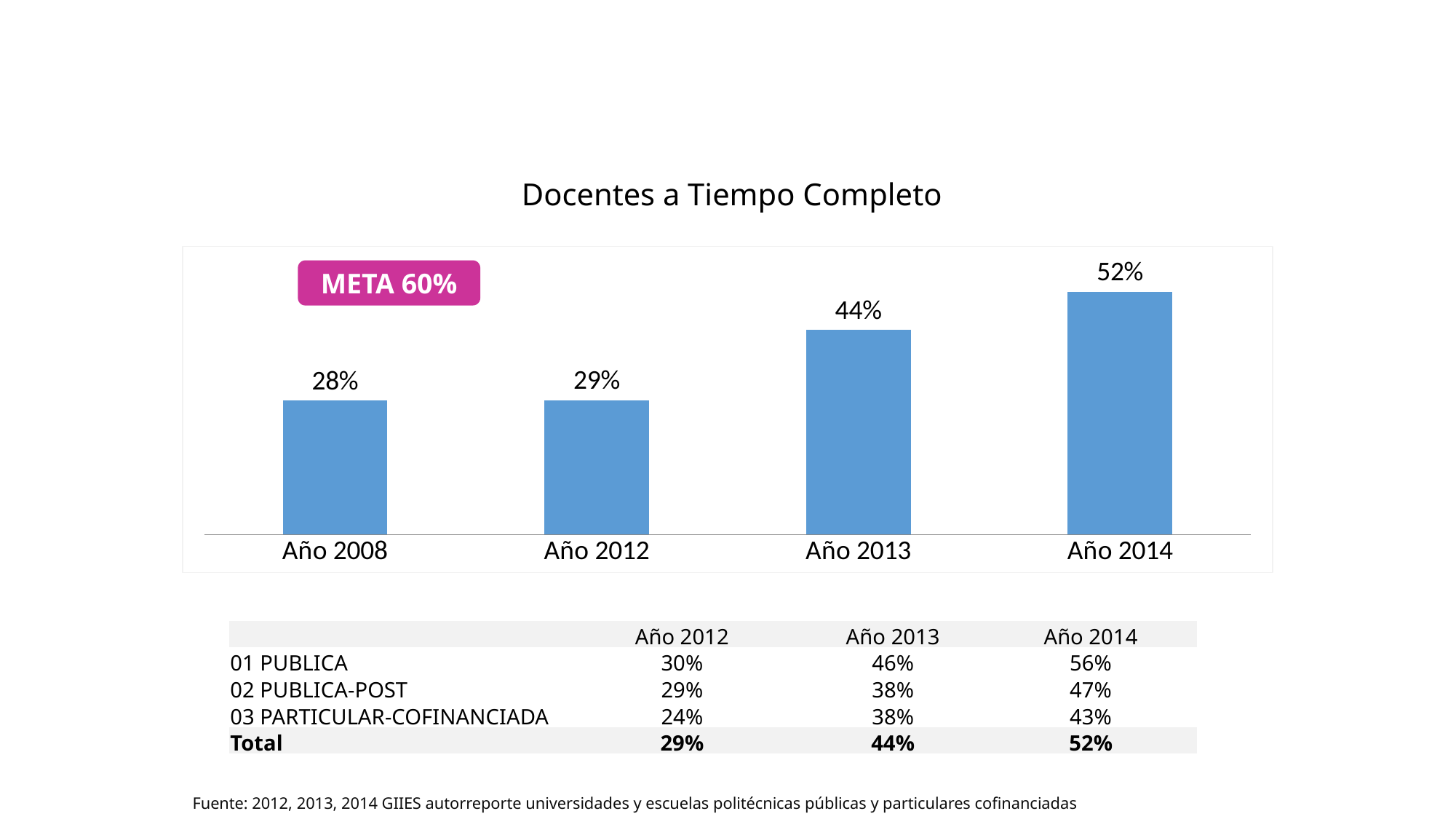
What is the difference between the values for Año 2014 and Año 2013 in the chart? 8% What target (META) is shown in the pink box on the chart? META 60% Which year has the highest value in the Docentes a Tiempo Completo chart? Año 2014 Which year has the lowest value in the Docentes a Tiempo Completo chart? Año 2008 What is the value for Año 2013 in the Docentes a Tiempo Completo chart? 44% What kind of chart is shown on the slide? Bar chart Which is larger in the chart, the value for Año 2012 or the value for Año 2013? Año 2013 How many bars are shown in the Docentes a Tiempo Completo chart? 4 What is the value for Año 2014 in the Docentes a Tiempo Completo chart? 52% What is the value for Año 2008 in the Docentes a Tiempo Completo chart? 28% Do the values in the chart rise or fall from Año 2008 to Año 2014? Rise What is the difference between the values for Año 2013 and Año 2012 in the chart? 15%